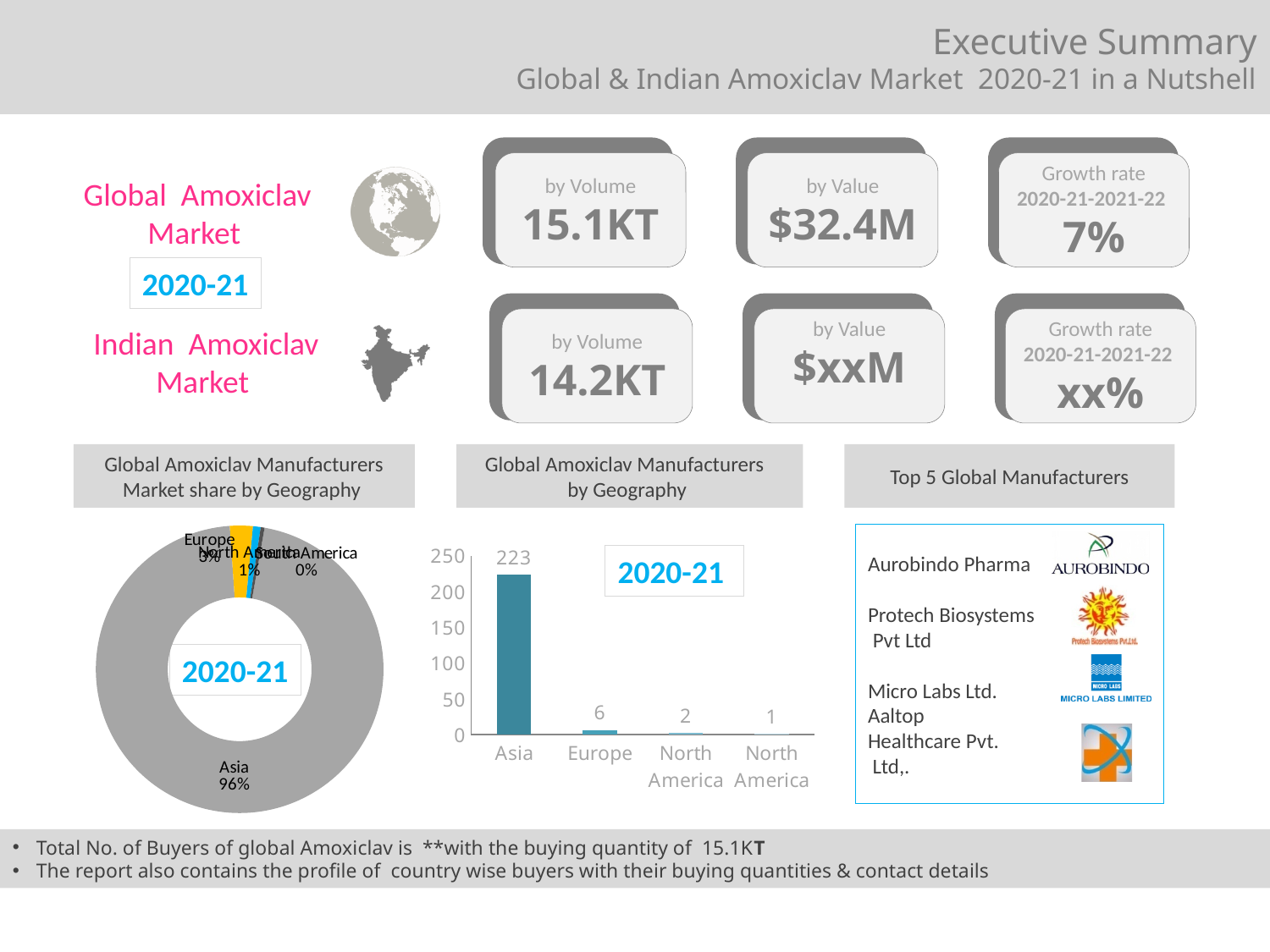
In the 'Global Amoxiclav Manufacturers by Geography' chart, is the value for Asia greater or less than 200? greater In the 'Global Amoxiclav Manufacturers Market share by Geography' chart, which region has the largest share? Asia What kind of chart is the 'Global Amoxiclav Manufacturers Market share by Geography' chart? doughnut chart In the 'Global Amoxiclav Manufacturers by Geography' chart, what is the difference between the values for Asia and Europe? 217 How many bars are shown in the 'Global Amoxiclav Manufacturers by Geography' chart? 4 What year label is shown in the centre of the 'Global Amoxiclav Manufacturers Market share by Geography' chart? 2020-21 In the 'Global Amoxiclav Manufacturers by Geography' chart, what is the value for Europe? 6 What kind of chart is the 'Global Amoxiclav Manufacturers by Geography' chart? bar chart In the 'Global Amoxiclav Manufacturers by Geography' chart, which category has the highest value? Asia In the 'Global Amoxiclav Manufacturers Market share by Geography' chart, what share does Asia have? 96% In the 'Global Amoxiclav Manufacturers by Geography' chart, which is larger, the value for Asia or the value for Europe? Asia In the 'Global Amoxiclav Manufacturers by Geography' chart, what is the value for Asia? 223